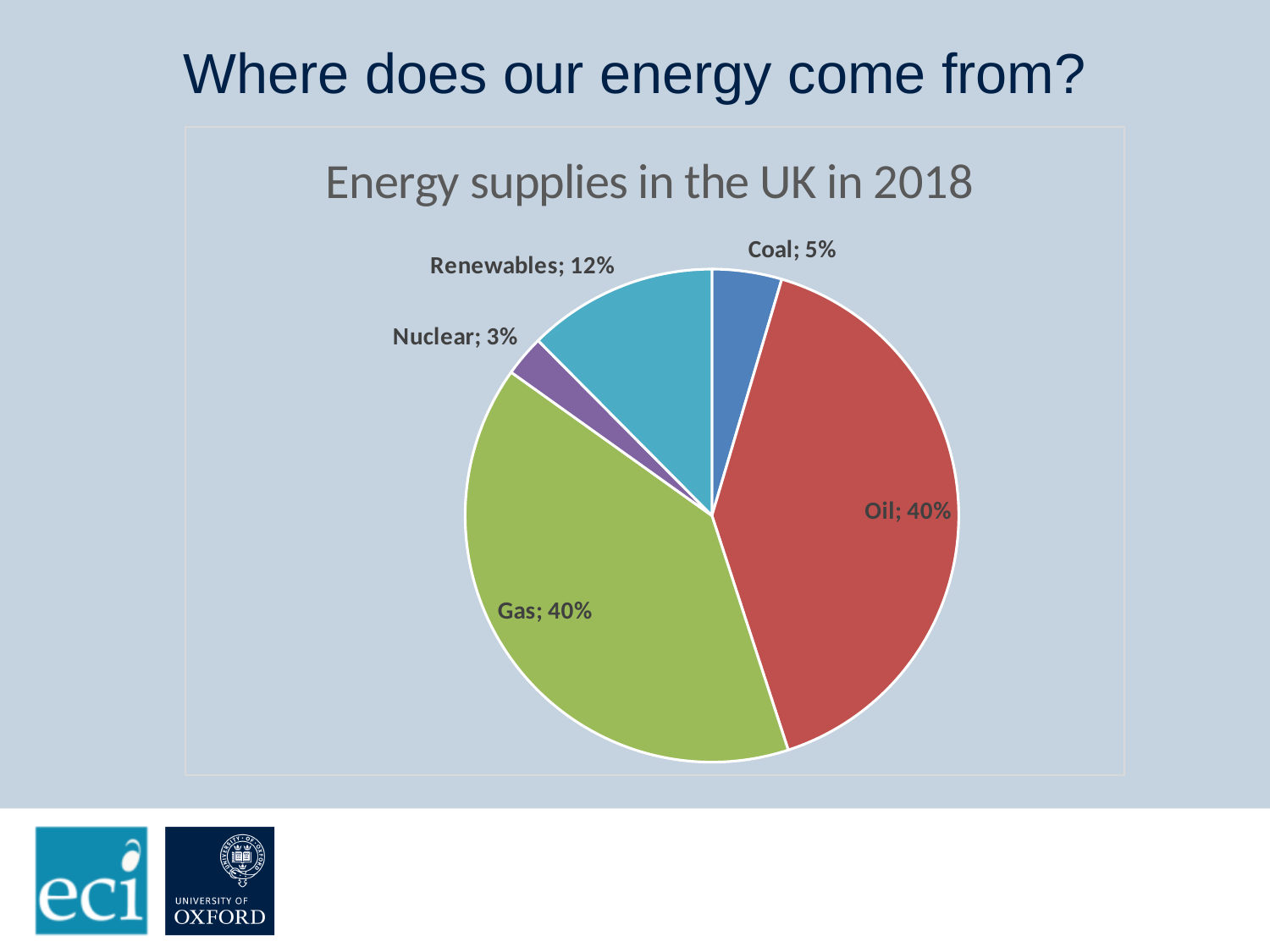
What is the title of the chart? Energy supplies in the UK in 2018 Which has a larger share, Coal or Renewables? Renewables Which energy source has the smallest share in the pie chart? Nuclear What kind of chart is shown on the slide? Pie chart Which has a larger share, Nuclear or Coal? Coal What share of UK energy supplies in 2018 came from Oil? 40% What share of UK energy supplies in 2018 came from Nuclear? 3% What share of UK energy supplies in 2018 came from Renewables? 12% What is the difference in share between Renewables and Coal? 7% What is the difference in share between Gas and Nuclear? 37% How many energy sources are shown in the pie chart? 5 What share of UK energy supplies in 2018 came from Coal? 5%